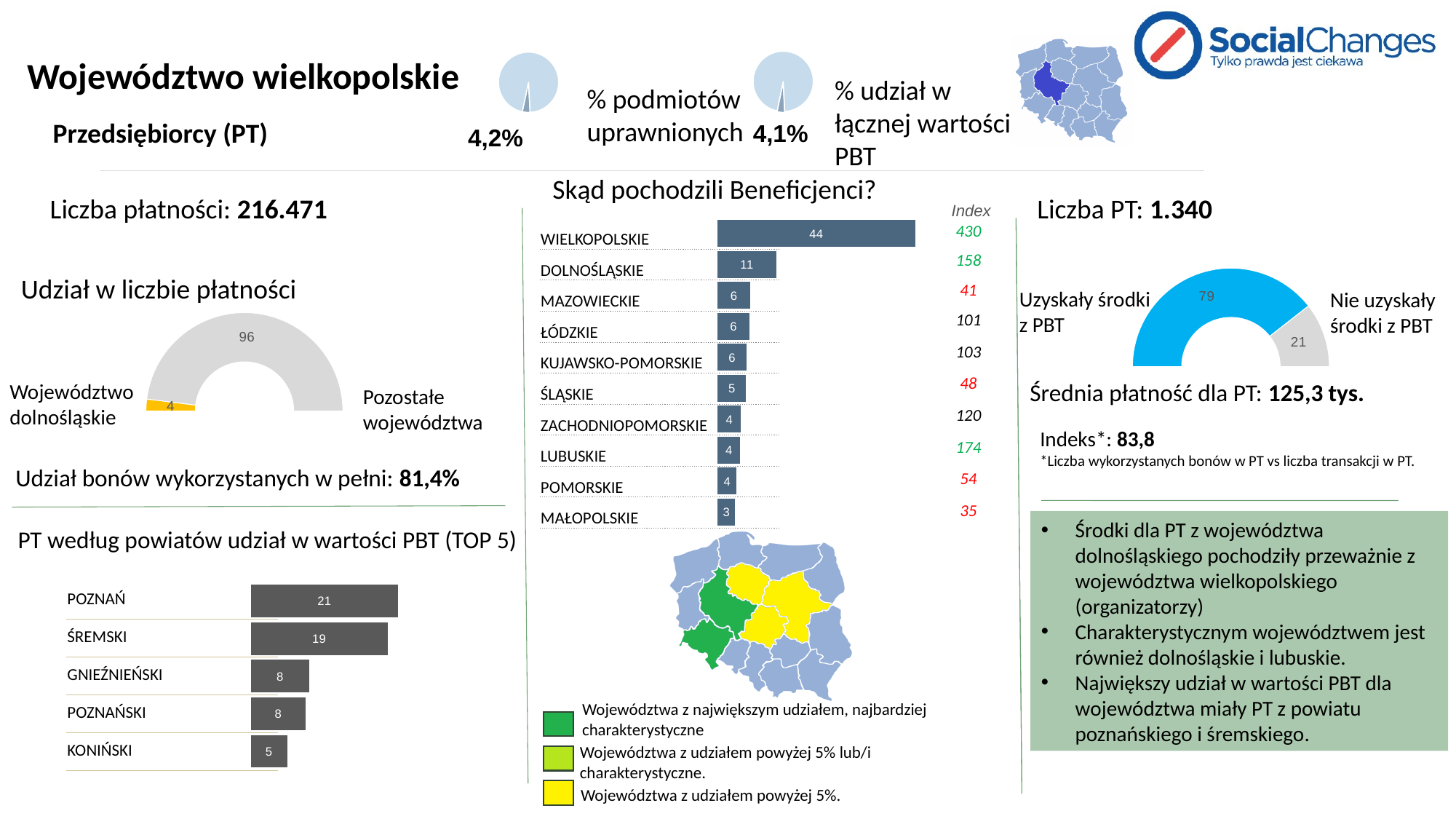
In the 'PT według powiatów udział w wartości PBT (TOP 5)' chart, which is larger: GNIEŹNIEŃSKI or KONIŃSKI? GNIEŹNIEŃSKI In the 'Skąd pochodzili Beneficjenci?' chart, which category has the lowest value? MAŁOPOLSKIE In the 'PT według powiatów udział w wartości PBT (TOP 5)' chart, which category has the highest value? POZNAŃ How many categories are shown in the 'Skąd pochodzili Beneficjenci?' chart? 10 In the 'PT według powiatów udział w wartości PBT (TOP 5)' chart, what is the value for ŚREMSKI? 19 In the 'Skąd pochodzili Beneficjenci?' chart, what is the difference between WIELKOPOLSKIE and DOLNOŚLĄSKIE? 33 In the 'Skąd pochodzili Beneficjenci?' chart, what is the value for DOLNOŚLĄSKIE? 11 In the 'Udział w liczbie płatności' chart, what is the value for Pozostałe województwa? 96 In the 'Liczba PT' donut chart on the right, what is the value for 'Uzyskały środki z PBT'? 79 What kind of chart is 'Skąd pochodzili Beneficjenci?'? bar chart In the 'Skąd pochodzili Beneficjenci?' chart, what is the value for WIELKOPOLSKIE? 44 In the 'PT według powiatów udział w wartości PBT (TOP 5)' chart, what is the difference between POZNAŃ and KONIŃSKI? 16